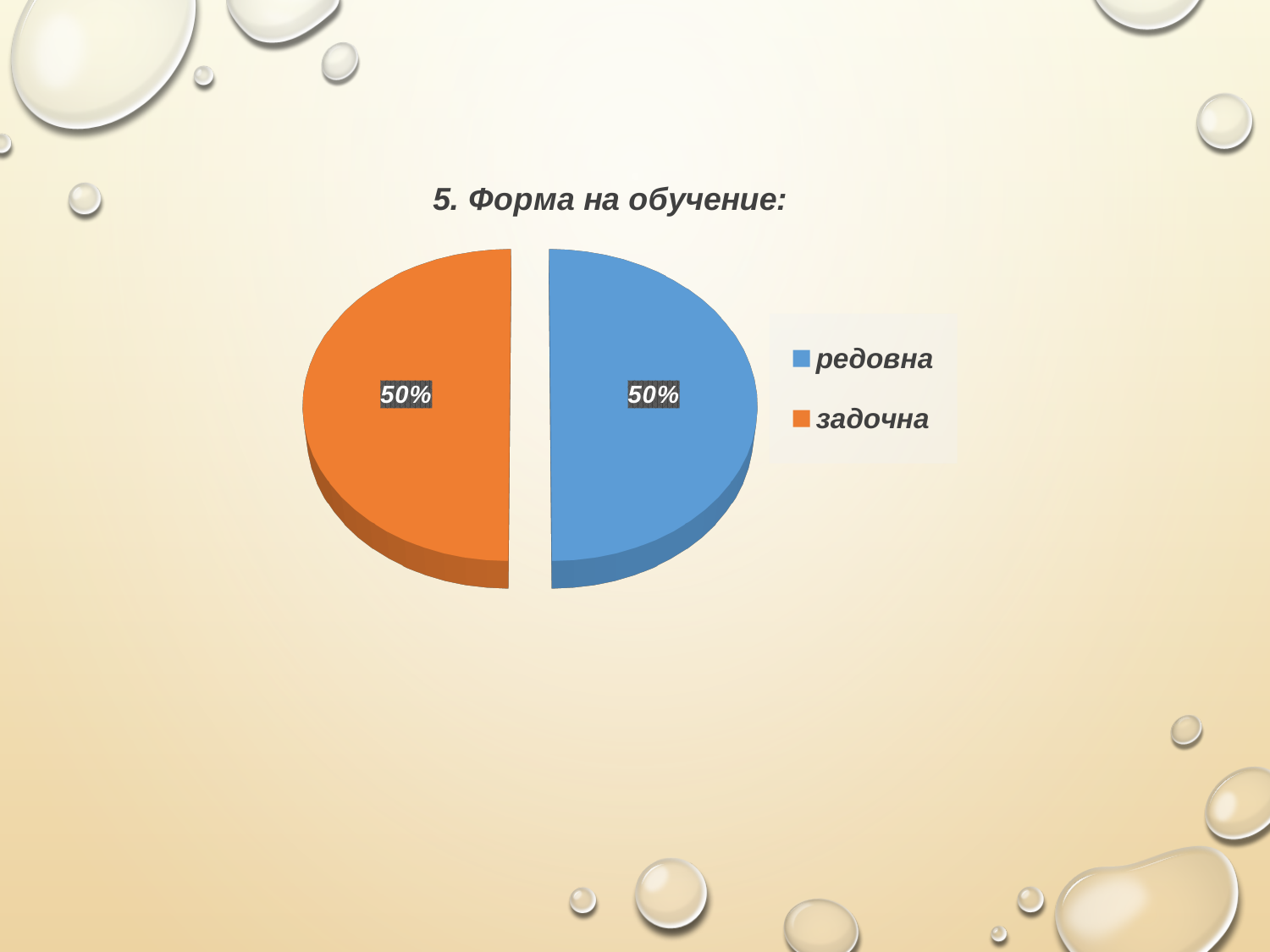
What is the title of the chart? 5. Форма на обучение: What share of the pie does редовна take? 50% How many entries does the legend list? 2 What is the total of the two slices shown? 100% What share of the pie does задочна take? 50% How many slices does the pie chart have? 2 Which colour represents задочна in the chart? orange What is the difference between the shares of редовна and задочна? 0% What kind of chart is shown on the slide? pie chart